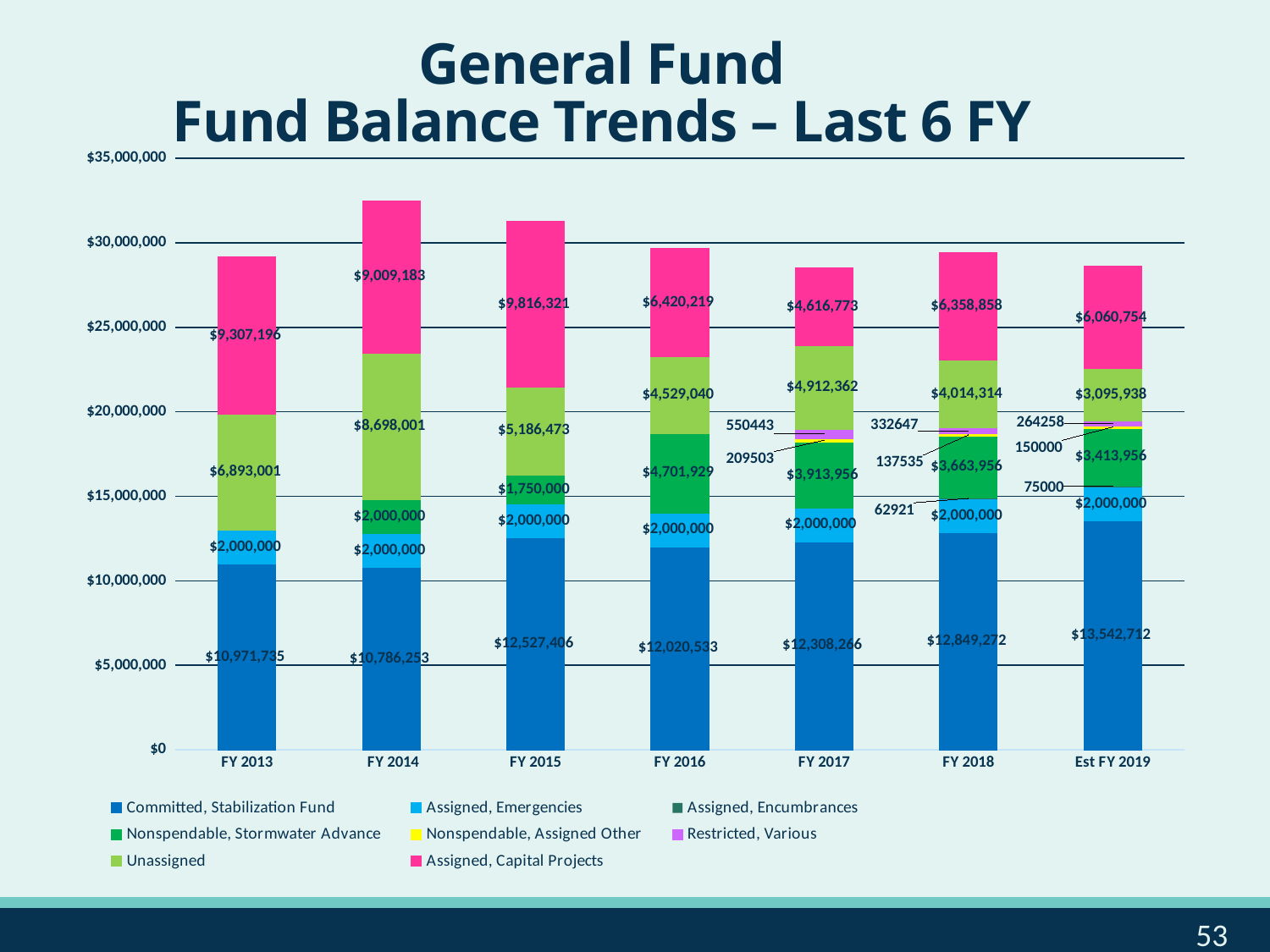
In which fiscal year is the Unassigned value the lowest? Est FY 2019 How many fiscal years are shown along the x axis? 7 Which year has the larger Unassigned value, FY 2016 or FY 2017? FY 2017 What is the difference between Assigned, Capital Projects in FY 2013 and FY 2014? $298,013 What kind of chart is shown on the slide? Stacked bar chart How many series does the legend list? 8 In which fiscal year is Committed, Stabilization Fund the highest? Est FY 2019 Is the total height of the FY 2014 bar greater or less than $30,000,000? greater What is the Unassigned value for FY 2014? $8,698,001 What is the value of Committed, Stabilization Fund for FY 2013? $10,971,735 What is the value of Assigned, Emergencies for FY 2016? $2,000,000 What is the value of Assigned, Capital Projects for FY 2015? $9,816,321